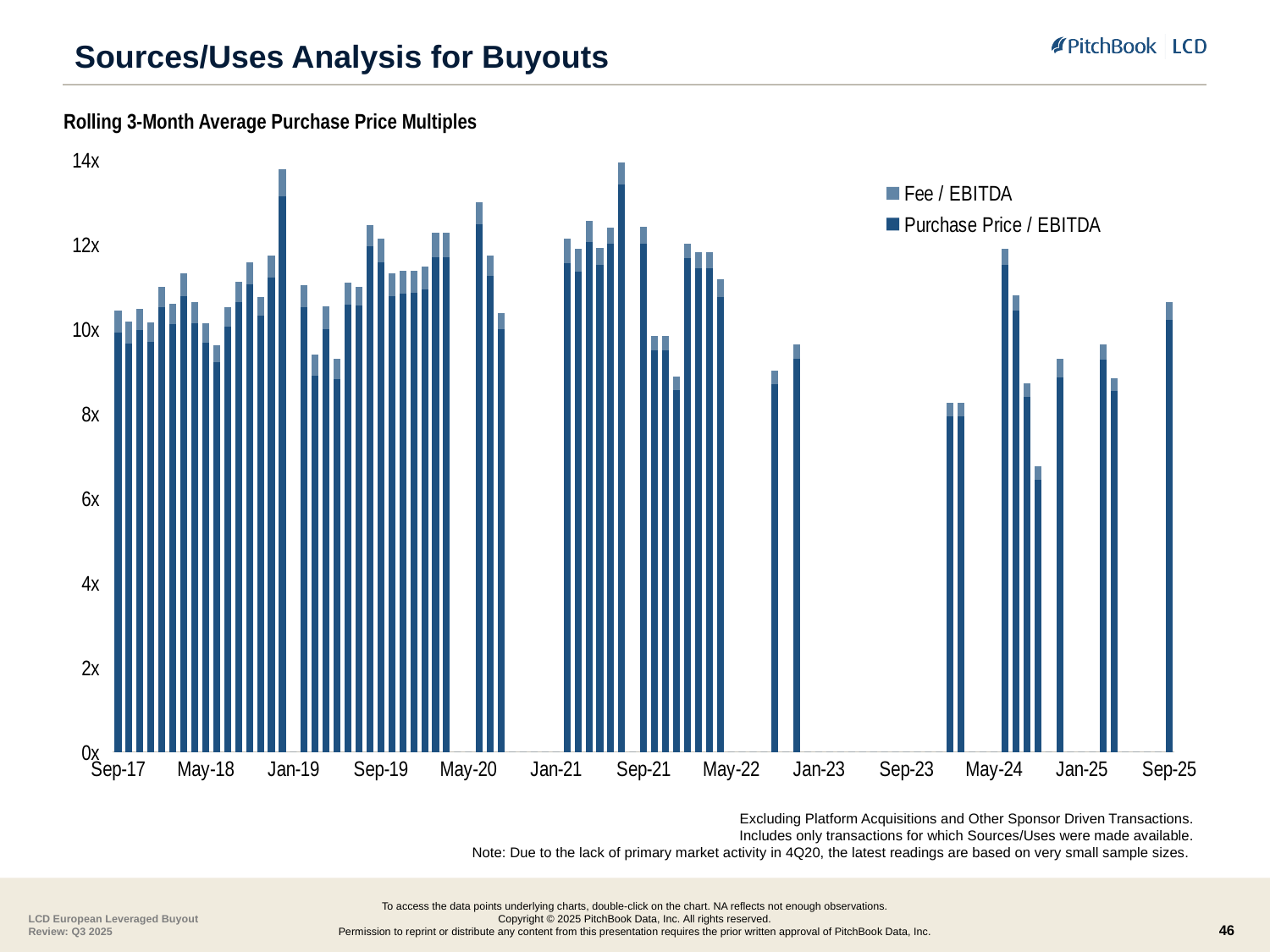
What is the highest value shown on the y axis? 14x Is the shortest bar in the chart greater or less than 8x? less What is the title of the chart? Rolling 3-Month Average Purchase Price Multiples What kind of chart is shown on the slide? Stacked bar chart Is the total value of the Sep-17 bar greater or less than 12x? less Is the total value of the Sep-25 bar greater or less than 10x? greater Which series makes up the larger part of each stacked bar, Fee / EBITDA or Purchase Price / EBITDA? Purchase Price / EBITDA What are the two series named in the legend? Fee / EBITDA and Purchase Price / EBITDA How many series does the legend list? 2 How many date labels are shown on the x axis? 13